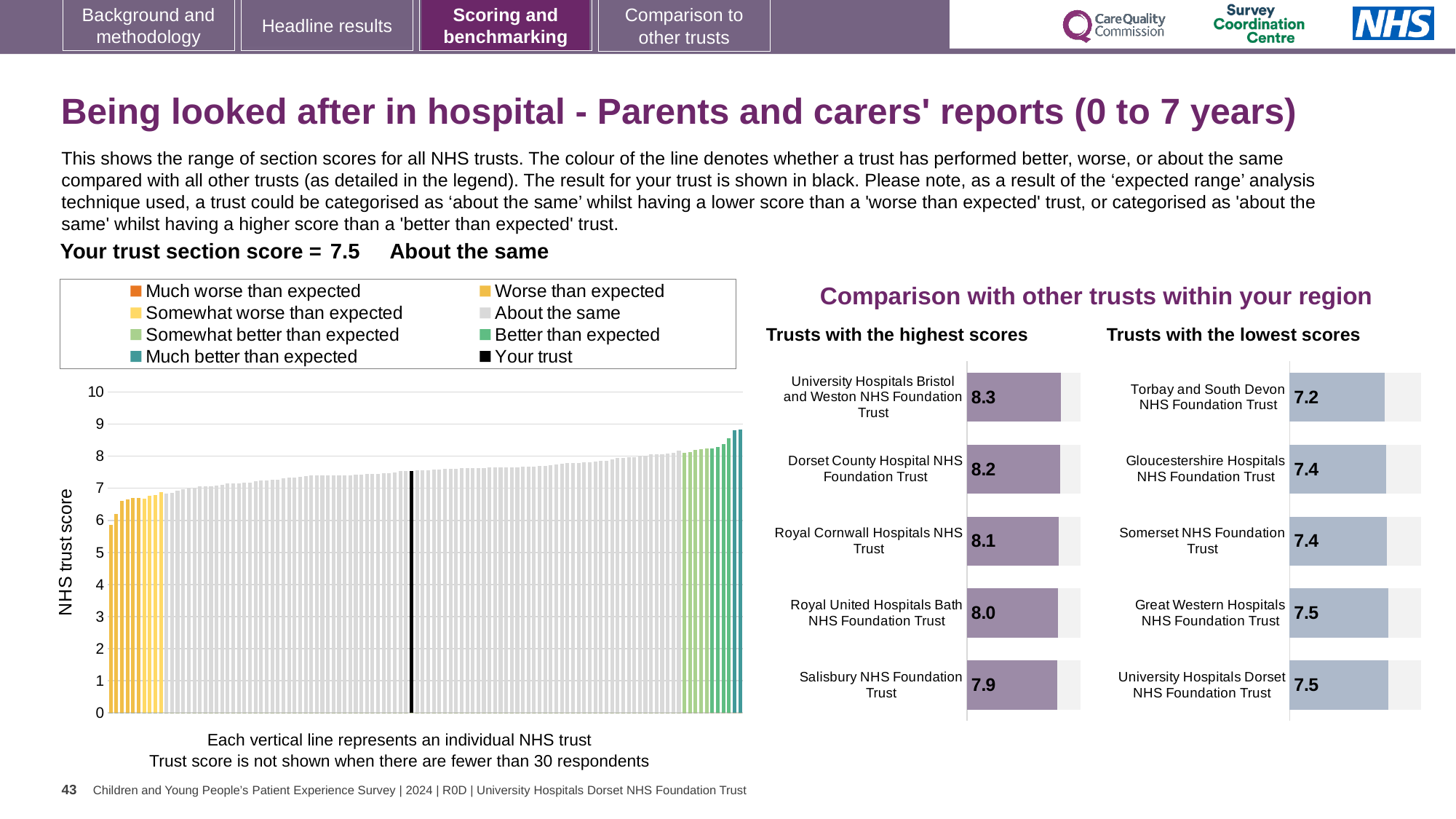
In the 'Trusts with the highest scores' chart, what is the difference between the scores of University Hospitals Bristol and Weston NHS Foundation Trust and Salisbury NHS Foundation Trust? 0.4 What kind of chart is the large chart on the left showing all NHS trust scores? Bar chart In the 'Trusts with the lowest scores' chart, which trust has the lowest score? Torbay and South Devon NHS Foundation Trust In the 'Trusts with the lowest scores' chart, what is the score for Torbay and South Devon NHS Foundation Trust? 7.2 In the 'Trusts with the highest scores' chart, which trust has the lowest score? Salisbury NHS Foundation Trust How many trusts are shown in the 'Trusts with the lowest scores' chart? 5 In the 'Trusts with the lowest scores' chart, which has the larger score: Gloucestershire Hospitals NHS Foundation Trust or Torbay and South Devon NHS Foundation Trust? Gloucestershire Hospitals NHS Foundation Trust In the large chart on the left, is the value for the black 'Your trust' bar greater or less than 7? greater In the 'Trusts with the lowest scores' chart, what is the difference between the scores of Great Western Hospitals NHS Foundation Trust and Torbay and South Devon NHS Foundation Trust? 0.3 How many entries does the legend of the large chart on the left list? 8 In the 'Trusts with the highest scores' chart, what is the score for Royal United Hospitals Bath NHS Foundation Trust? 8.0 In the 'Trusts with the highest scores' chart, what is the score for University Hospitals Bristol and Weston NHS Foundation Trust? 8.3